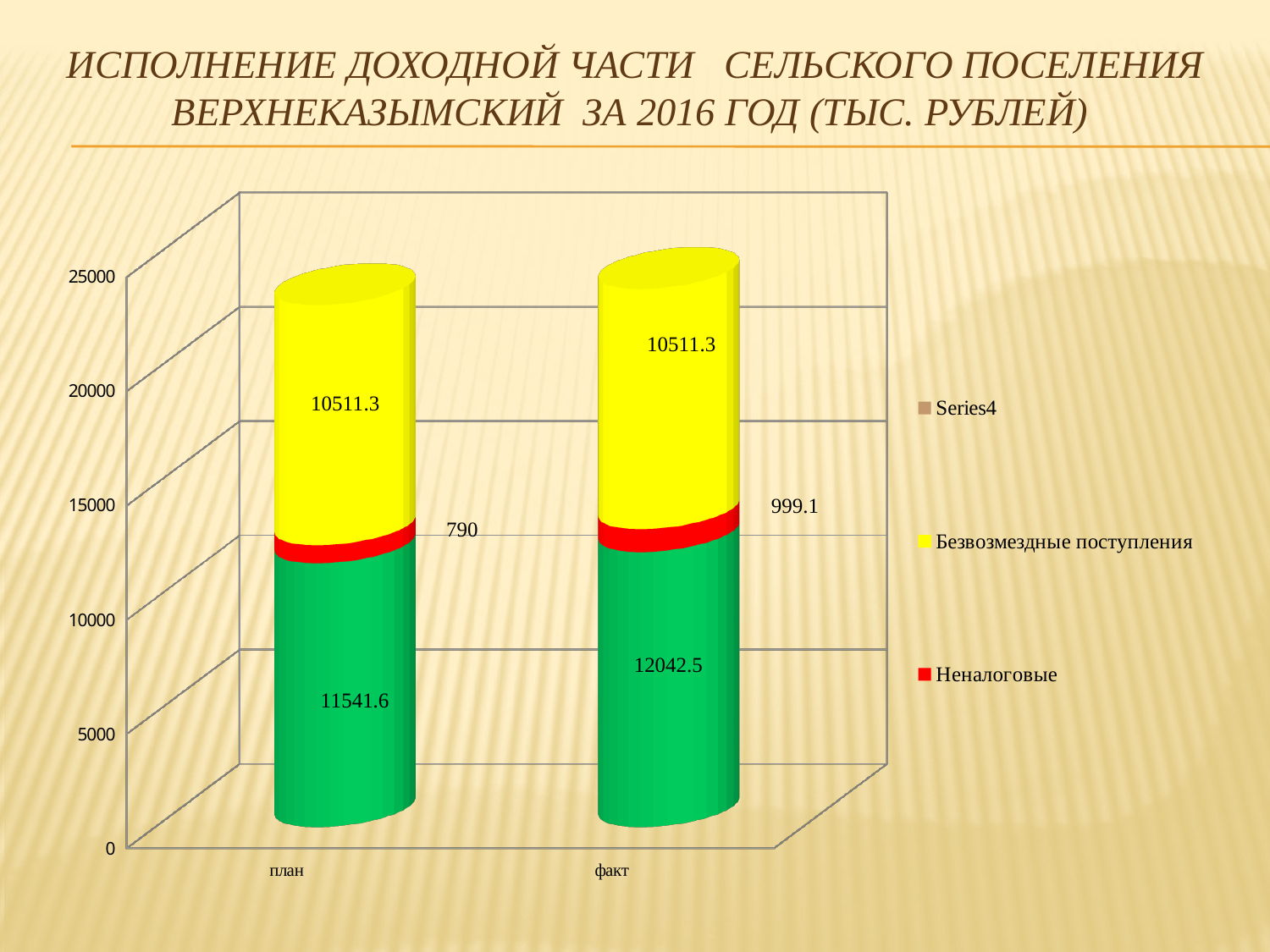
Which category has the larger Неналоговые value, план or факт? факт What is the value of the green segment for факт? 12042.5 What is the difference between the Неналоговые values for факт and план? 209.1 What is the value of Неналоговые for план? 790 Is the total of the stacked bar for факт greater or less than 20000? greater What is the total of the stacked bar for план? 22842.9 What kind of chart is shown on the slide? stacked bar chart How many series does the legend list? 3 How many categories are shown on the x axis? 2 What is the value of Неналоговые for факт? 999.1 What is the value of Безвозмездные поступления for план? 10511.3 What is the total of the stacked bar for факт? 23552.9